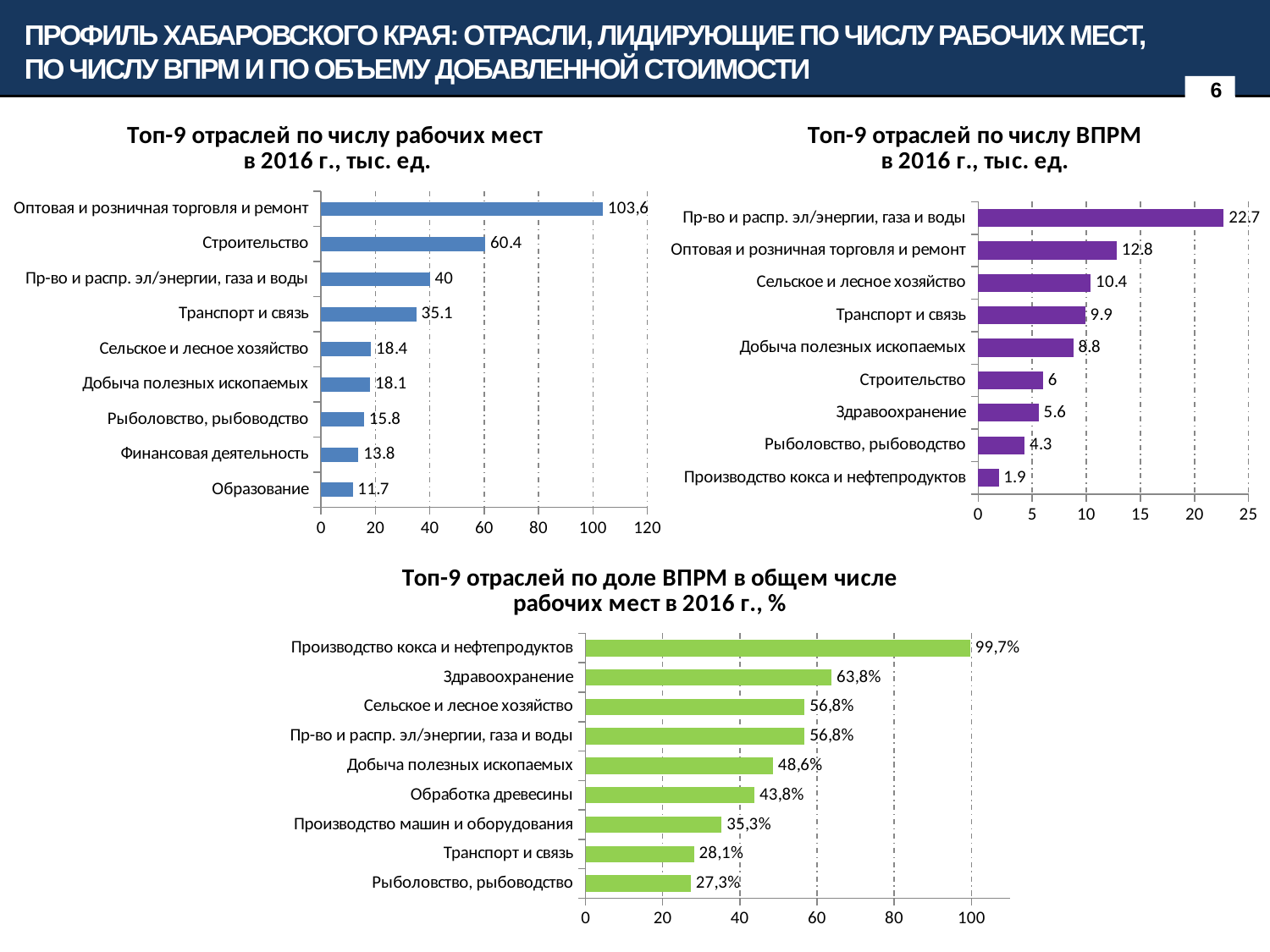
What type of chart is 'Топ-9 отраслей по доле ВПРМ в общем числе рабочих мест в 2016 г., %'? Bar chart In the chart 'Топ-9 отраслей по числу ВПРМ в 2016 г., тыс. ед.', which industry has the lowest value? Производство кокса и нефтепродуктов In the chart 'Топ-9 отраслей по доле ВПРМ в общем числе рабочих мест в 2016 г., %', what is the difference between Обработка древесины and Производство машин и оборудования? 8,5% In the chart 'Топ-9 отраслей по числу рабочих мест в 2016 г., тыс. ед.', which industry has the highest value? Оптовая и розничная торговля и ремонт In the chart 'Топ-9 отраслей по числу рабочих мест в 2016 г., тыс. ед.', what is the value for Строительство? 60.4 In the chart 'Топ-9 отраслей по доле ВПРМ в общем числе рабочих мест в 2016 г., %', what is the value for Здравоохранение? 63,8% In the chart 'Топ-9 отраслей по числу ВПРМ в 2016 г., тыс. ед.', which is larger: Строительство or Здравоохранение? Строительство In the chart 'Топ-9 отраслей по числу рабочих мест в 2016 г., тыс. ед.', which industry has the lowest value? Образование In the chart 'Топ-9 отраслей по доле ВПРМ в общем числе рабочих мест в 2016 г., %', which industry has the highest share? Производство кокса и нефтепродуктов In the chart 'Топ-9 отраслей по числу рабочих мест в 2016 г., тыс. ед.', what is the difference between Строительство and Транспорт и связь? 25.3 In the chart 'Топ-9 отраслей по числу ВПРМ в 2016 г., тыс. ед.', what is the value for Сельское и лесное хозяйство? 10.4 In the chart 'Топ-9 отраслей по числу ВПРМ в 2016 г., тыс. ед.', how many industries are shown? 9